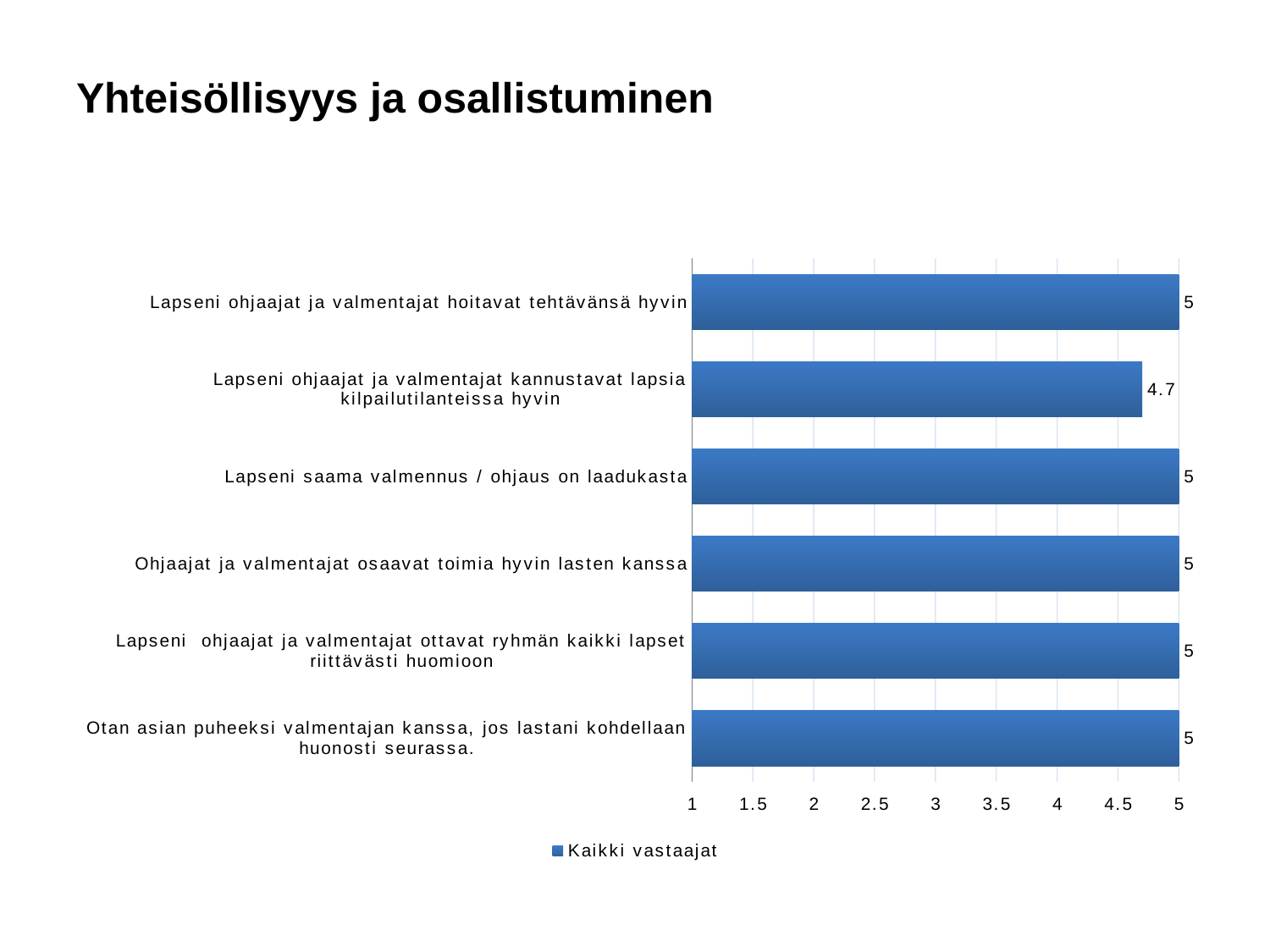
What is the name of the series in the legend? Kaikki vastaajat What kind of chart is shown on the slide? bar chart Which category has the lowest value? Lapseni ohjaajat ja valmentajat kannustavat lapsia kilpailutilanteissa hyvin What is the value for "Lapseni saama valmennus / ohjaus on laadukasta"? 5 How many categories are shown in the chart? 6 What is the value for "Otan asian puheeksi valmentajan kanssa, jos lastani kohdellaan huonosti seurassa."? 5 Which is larger: the value for "Ohjaajat ja valmentajat osaavat toimia hyvin lasten kanssa" or the value for "Lapseni ohjaajat ja valmentajat kannustavat lapsia kilpailutilanteissa hyvin"? Ohjaajat ja valmentajat osaavat toimia hyvin lasten kanssa How many categories have a value of 5? 5 How many series does the legend list? 1 What is the value for "Lapseni ohjaajat ja valmentajat kannustavat lapsia kilpailutilanteissa hyvin"? 4.7 Is the value for "Lapseni ohjaajat ja valmentajat kannustavat lapsia kilpailutilanteissa hyvin" greater or less than 4.5? greater What is the difference between the value for "Lapseni ohjaajat ja valmentajat hoitavat tehtävänsä hyvin" and the value for "Lapseni ohjaajat ja valmentajat kannustavat lapsia kilpailutilanteissa hyvin"? 0.3